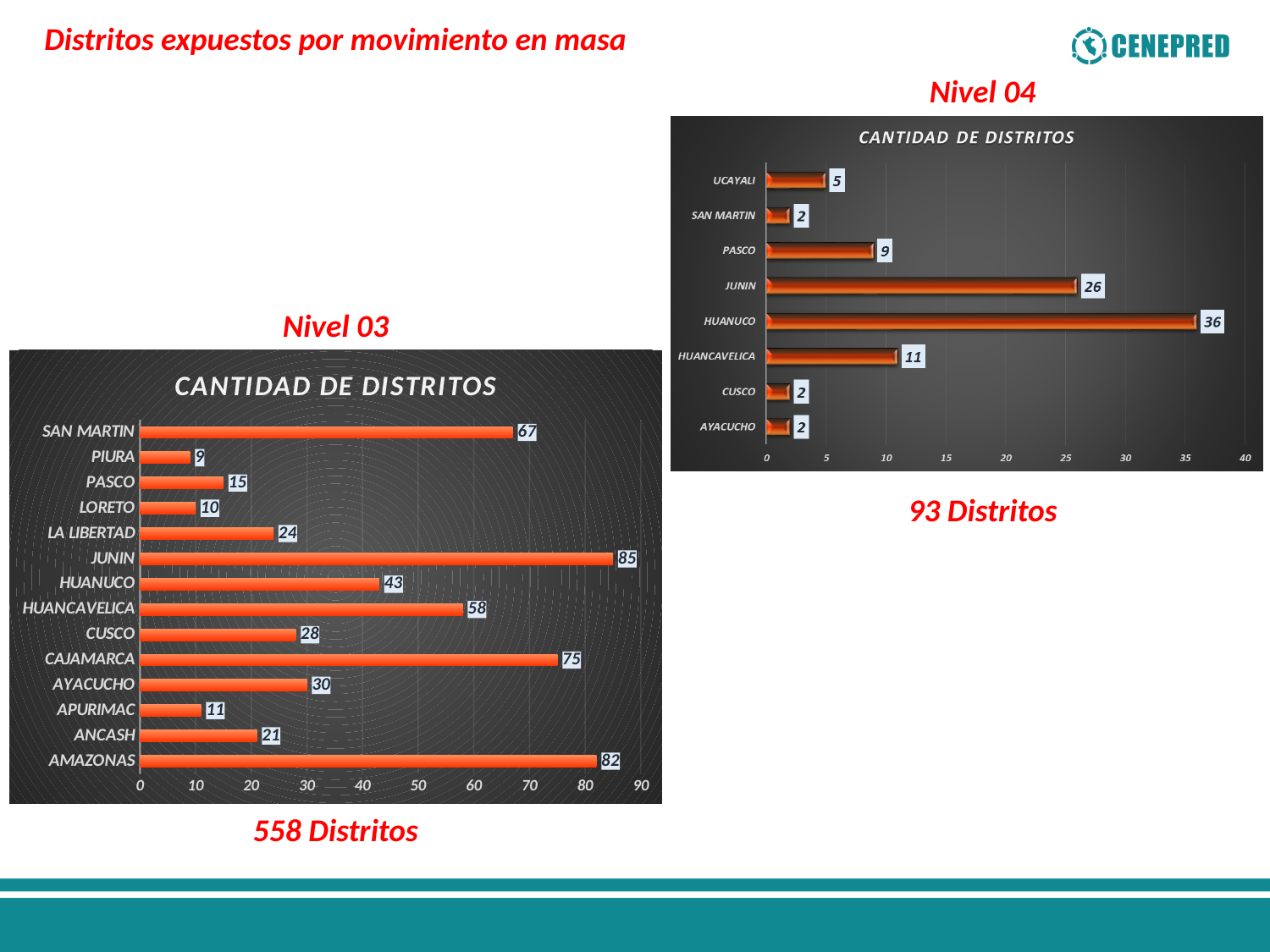
In the Nivel 03 chart, how many districts does JUNIN have? 85 In the Nivel 03 chart, what is the value for LA LIBERTAD? 24 In the Nivel 04 chart, what is the difference between HUANUCO and JUNIN? 10 How many regions are shown in the Nivel 04 chart? 8 In the Nivel 04 chart, what is the value for HUANCAVELICA? 11 In the Nivel 03 chart, which is larger, HUANUCO or HUANCAVELICA? HUANCAVELICA In the Nivel 03 chart, what is the difference between AMAZONAS and CAJAMARCA? 7 How many regions are shown in the Nivel 03 chart? 14 In the Nivel 04 chart, which region has the highest number of districts? HUANUCO In the Nivel 03 chart, which region has the lowest number of districts? PIURA What type of chart is the Nivel 04 chart? Bar chart What is the title shown inside the Nivel 03 chart? CANTIDAD DE DISTRITOS